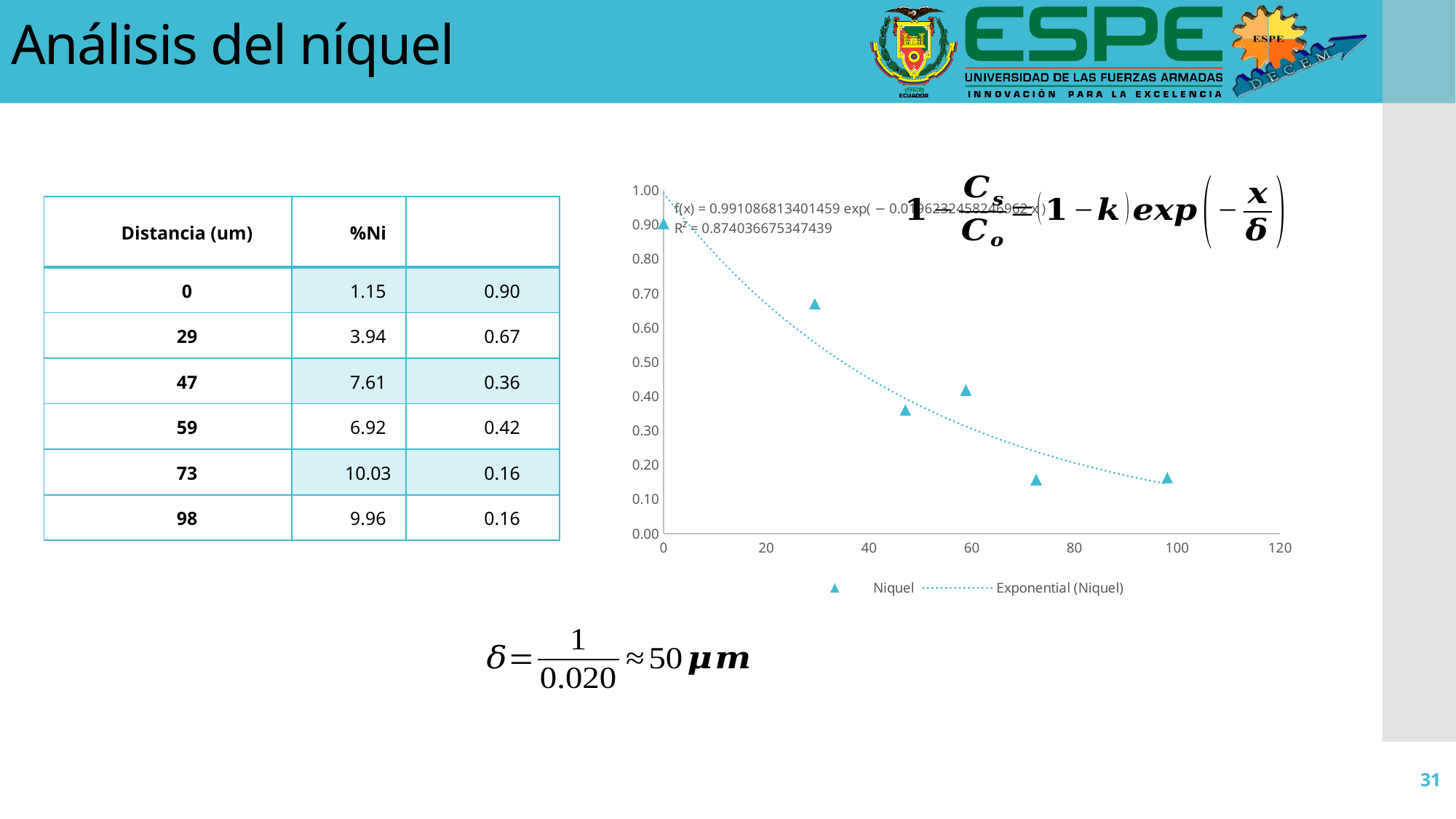
What kind of chart is shown on the slide? scatter chart Which Niquel point is higher, the one near x = 47 or the one near x = 59? the one near x = 59 What type of trendline is fitted to the Niquel data according to the legend? Exponential (Niquel) What is the highest tick value shown on the x axis of the chart? 120 Do the Niquel values rise or fall as the x value increases? fall How many entries does the chart legend list? 2 Is the value of the Niquel point near x = 73 greater or less than 0.20? less At which x value does the Niquel series reach its highest point? 0 What is the y value of the Niquel point at x = 0? 0.90 Is the value of the Niquel point near x = 29 greater or less than 0.60? greater How many data points are plotted in the Niquel series? 6 Is the value of the Niquel point near x = 47 greater or less than 0.40? less